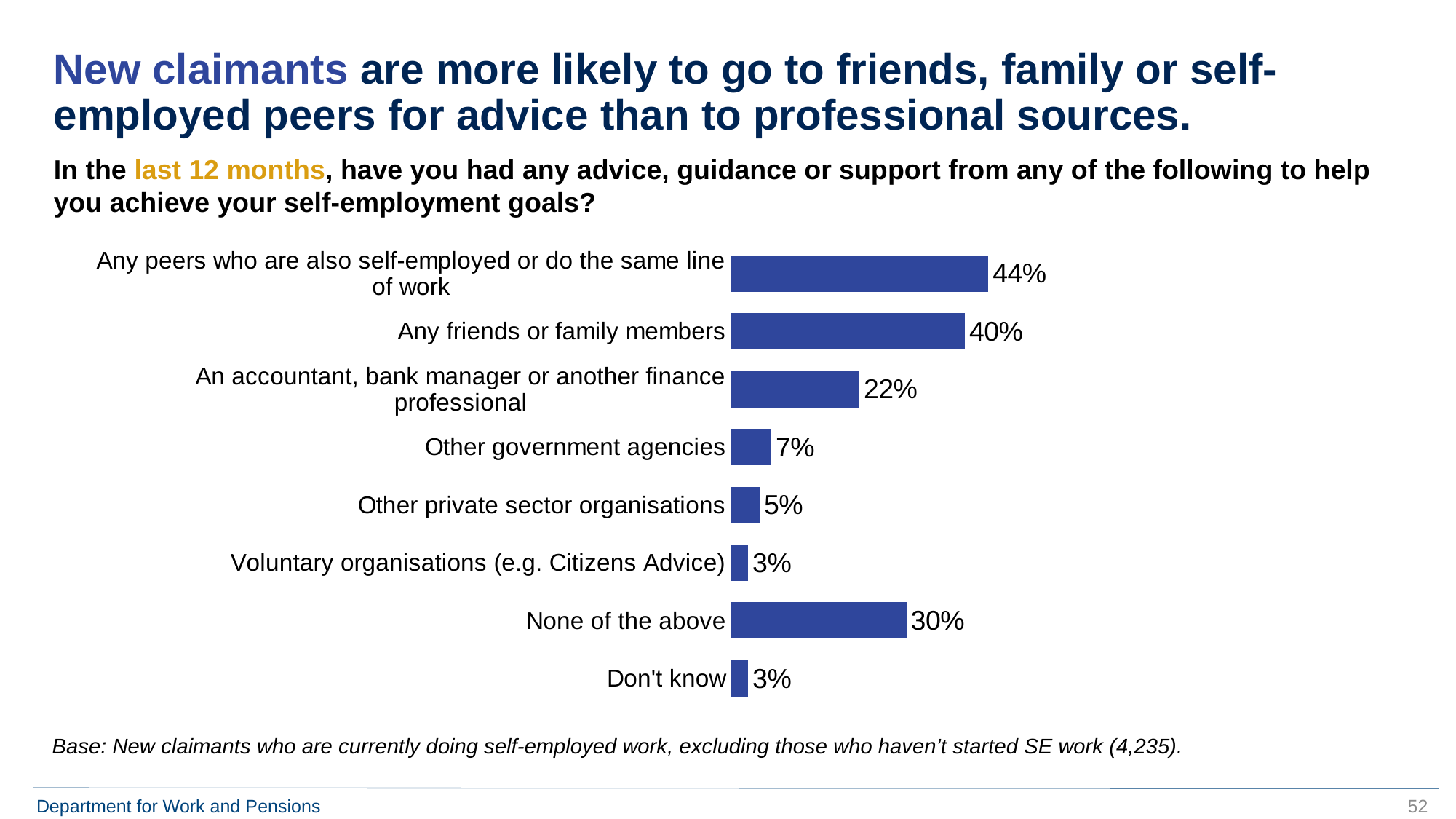
What is the value for 'An accountant, bank manager or another finance professional'? 22% What percentage selected 'None of the above'? 30% What is the difference between 'None of the above' and 'Don't know'? 27% What is the base size stated below the chart? 4,235 What percentage of new claimants had advice from any friends or family members? 40% How many categories are shown in the chart? 8 What is the difference between the value for peers who are also self-employed and the value for friends or family members? 4% What is the value for 'Other government agencies'? 7% What kind of chart is shown on the slide? Bar chart Which category has the highest value? Any peers who are also self-employed or do the same line of work Which is larger: the value for 'Other private sector organisations' or 'Other government agencies'? Other government agencies Which two categories share the lowest value of 3%? Voluntary organisations (e.g. Citizens Advice) and Don't know